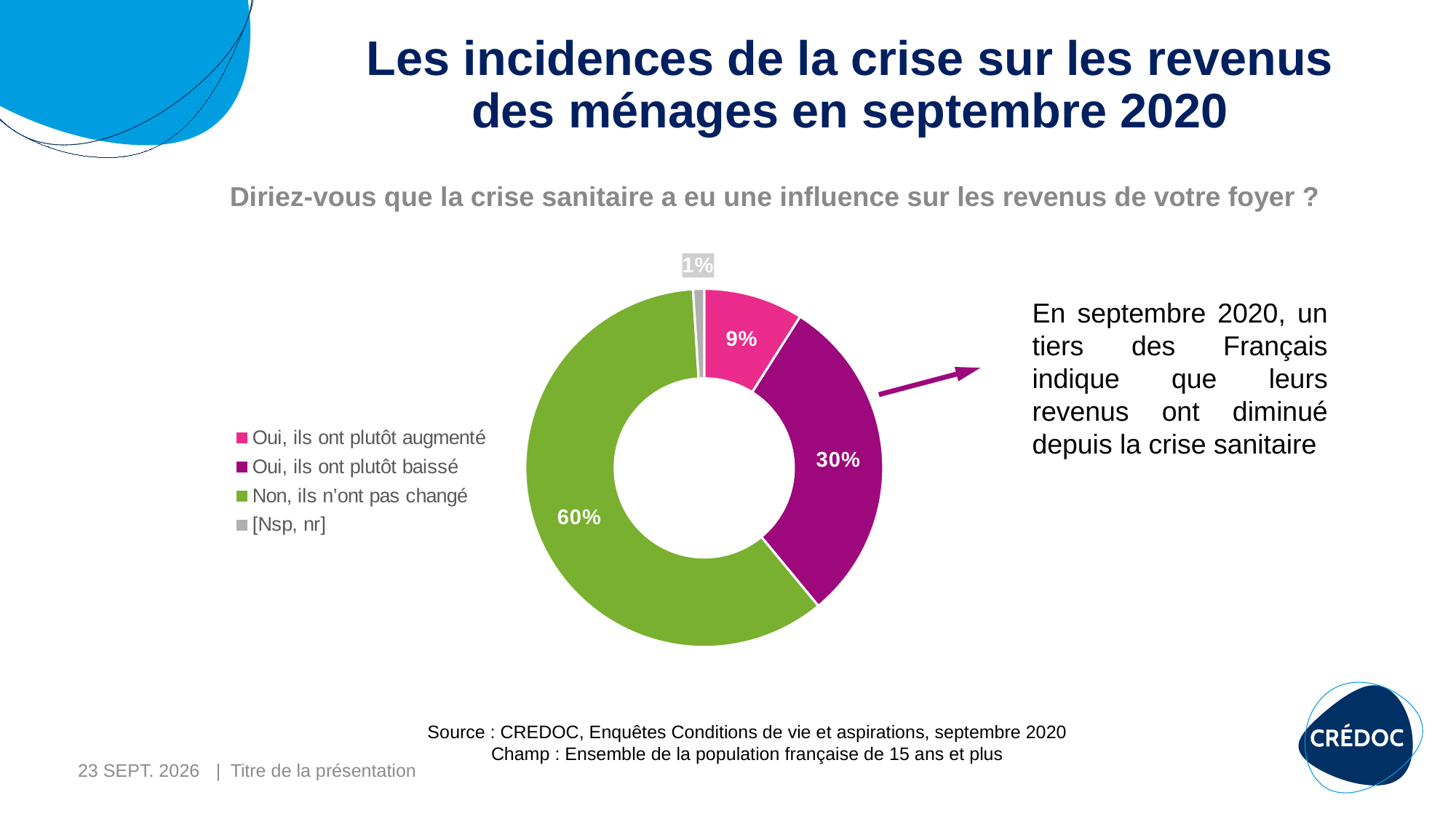
What is the difference in percentage points between "Oui, ils ont plutôt baissé" and "Oui, ils ont plutôt augmenté"? 21 percentage points What is the combined share of respondents who said their income had either increased or decreased? 39% Which is larger: the share for "Oui, ils ont plutôt baissé" or the share for "Oui, ils ont plutôt augmenté"? Oui, ils ont plutôt baissé How many categories does the legend of the chart list? 4 What colour is used for the "Non, ils n'ont pas changé" category in the chart? Green Which category has the smallest share of the chart? [Nsp, nr] What percentage of respondents said their income had rather decreased ("Oui, ils ont plutôt baissé")? 30% What percentage of respondents said their income had rather increased ("Oui, ils ont plutôt augmenté")? 9% Which category has the largest share of the chart? Non, ils n'ont pas changé What percentage of respondents said their income had not changed ("Non, ils n'ont pas changé")? 60% What type of chart is shown on the slide? Pie chart (doughnut) What percentage is shown for the "[Nsp, nr]" category? 1%